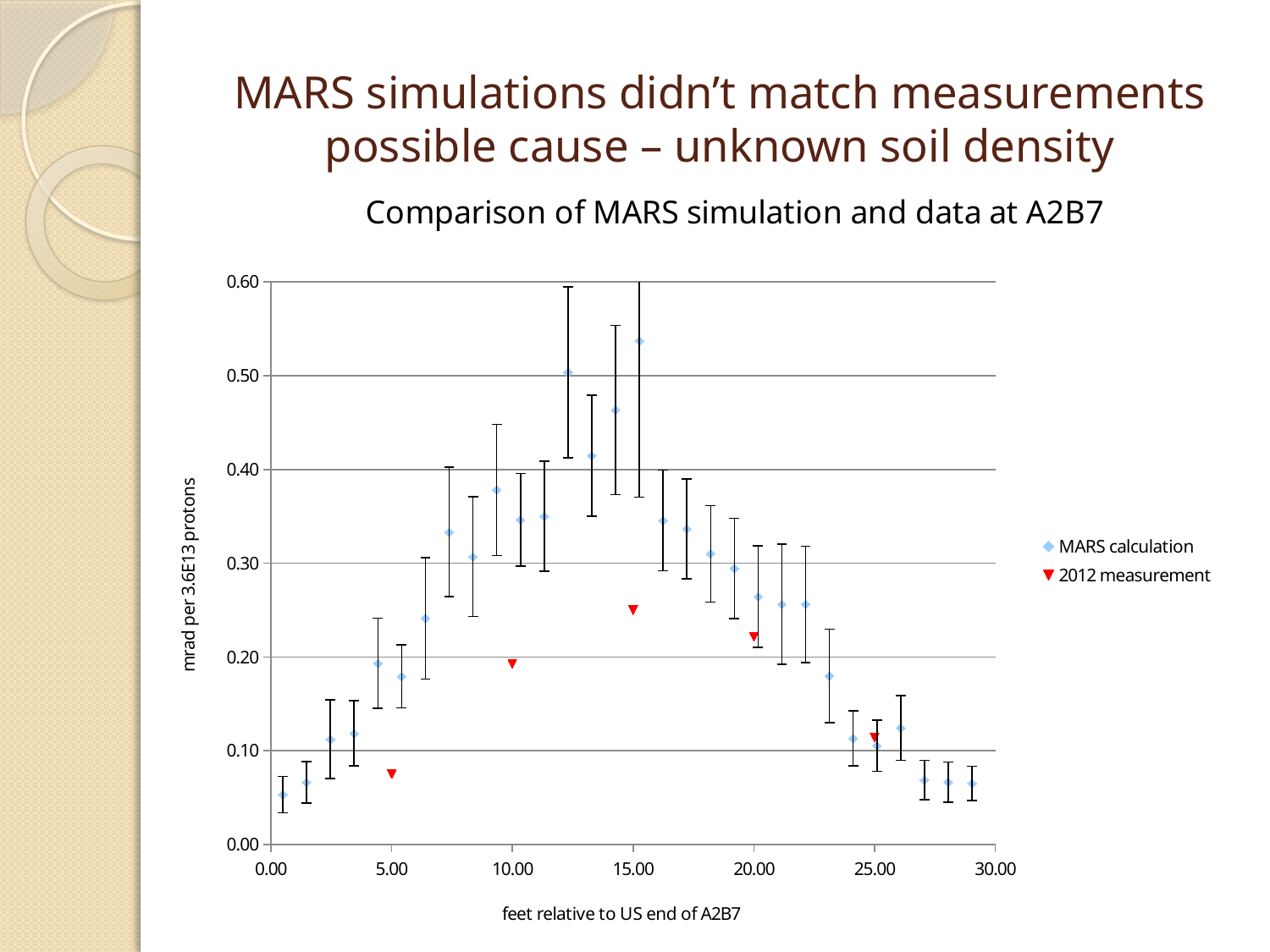
How many series does the chart legend list? 2 What kind of chart is shown on the slide? Scatter chart Is the 2012 measurement value near 15.00 feet greater or less than 0.30? less Near 15.00 feet, which series has the larger value, MARS calculation or 2012 measurement? MARS calculation What is the title of the chart? Comparison of MARS simulation and data at A2B7 Is the highest MARS calculation value greater or less than 0.50? greater How many 2012 measurement points (red triangles) are plotted? 5 What are the two series named in the legend? MARS calculation and 2012 measurement Is the 2012 measurement value near 5.00 feet greater or less than 0.10? less Which series reaches the highest value on the chart? MARS calculation Do the MARS calculation values rise or fall as the x axis goes from 0.00 to 15.00 feet? rise Do the MARS calculation values rise or fall as the x axis goes from 15.00 to 30.00 feet? fall